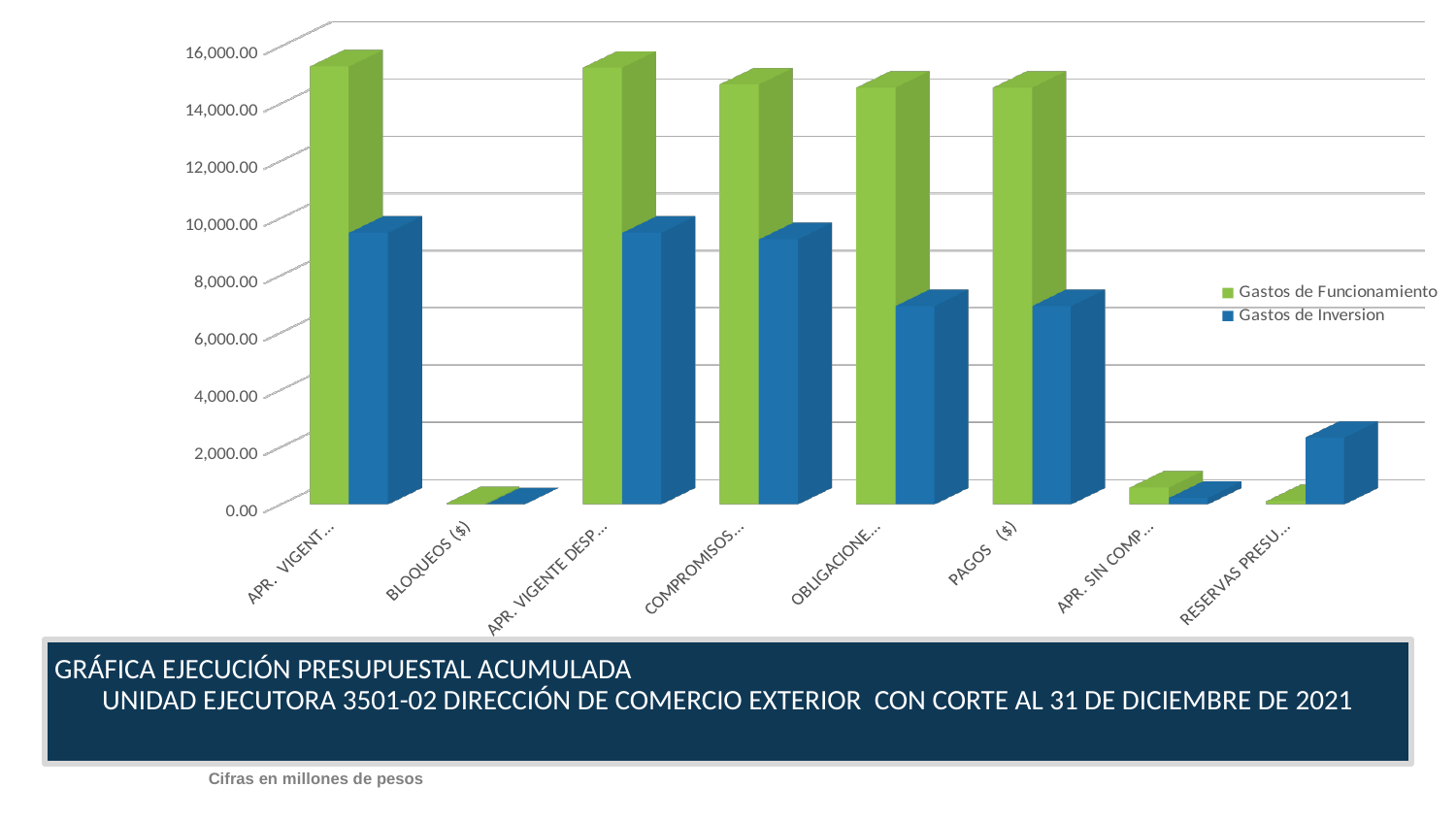
Is the Gastos de Funcionamiento value for PAGOS ($) greater or less than 12,000.00? greater Is the Gastos de Inversion value for PAGOS ($) greater or less than 4,000.00? greater For PAGOS ($), which series has the larger value, Gastos de Funcionamiento or Gastos de Inversion? Gastos de Funcionamiento Which series is shown in blue? Gastos de Inversion For Gastos de Inversion, which is larger, the value for PAGOS ($) or the value for BLOQUEOS ($)? PAGOS ($) What unit note is printed below the chart? Cifras en millones de pesos Is the Gastos de Inversion value for PAGOS ($) greater or less than 10,000.00? less How many categories are shown on the x axis? 8 What kind of chart is shown on the slide? Bar chart How many series does the legend list? 2